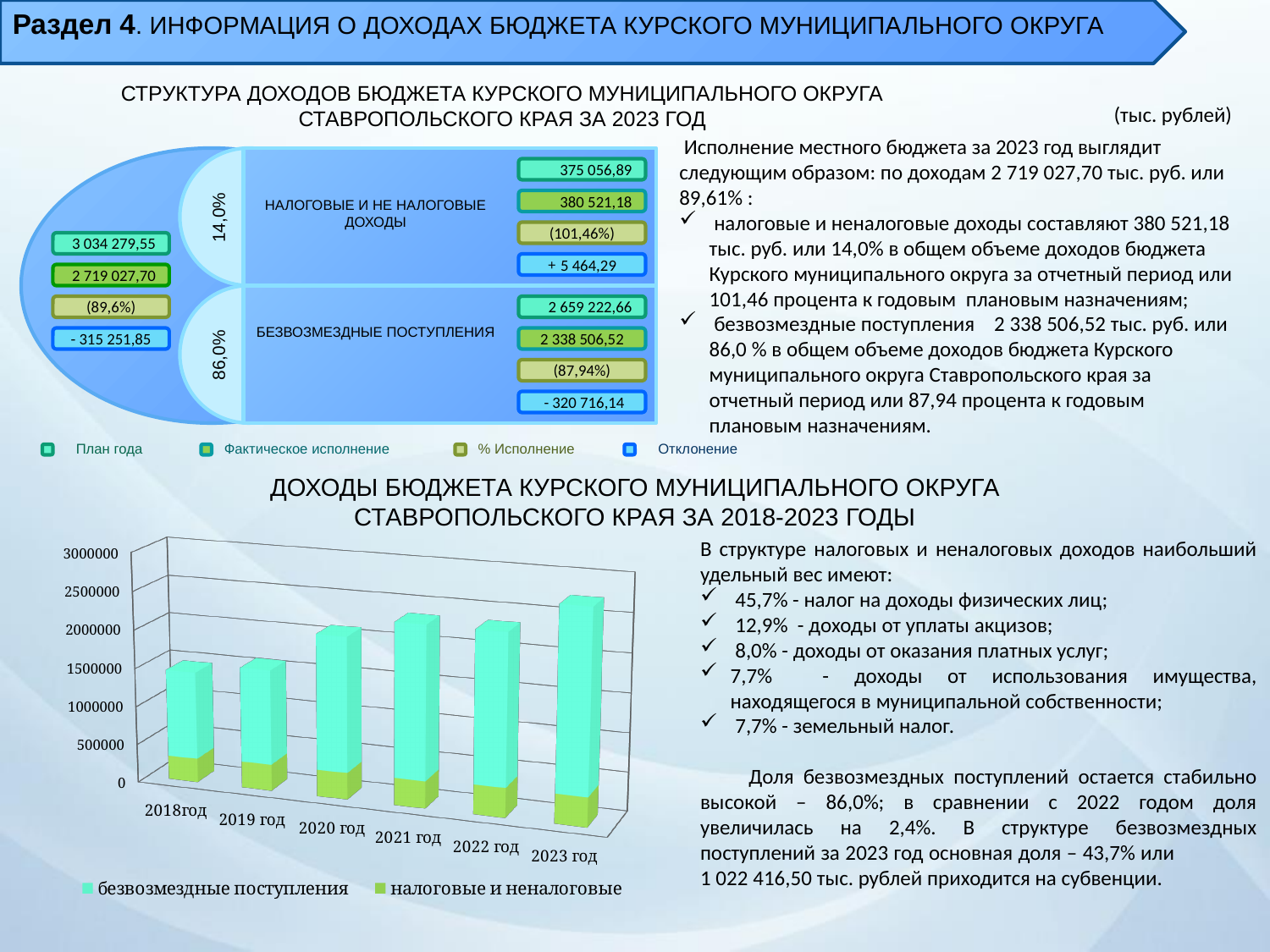
How many years (categories) are shown on the x axis of the bar chart at the bottom of the slide? 6 In the bottom bar chart, what colour represents the series 'налоговые и неналоговые'? Green In the bottom bar chart, is the total bar for 2020 год greater or less than 1500000? greater In the bottom bar chart, which year has the highest total bar? 2023 год What kind of chart is shown under the title 'ДОХОДЫ БЮДЖЕТА КУРСКОГО МУНИЦИПАЛЬНОГО ОКРУГА СТАВРОПОЛЬСКОГО КРАЯ ЗА 2018-2023 ГОДЫ'? Stacked bar chart In the bottom bar chart, which series forms the larger part of each stacked bar? безвозмездные поступления In the bottom bar chart, is the total bar for 2023 год greater or less than 2000000? greater What is the highest value shown on the vertical axis of the bottom bar chart? 3000000 In the bottom bar chart, is the total bar for 2018 год greater or less than 2000000? less How many series does the legend of the bottom bar chart list? 2 In the bottom bar chart, which total bar is taller: 2022 год or 2023 год? 2023 год In the bottom bar chart, which total bar is taller: 2018 год or 2021 год? 2021 год